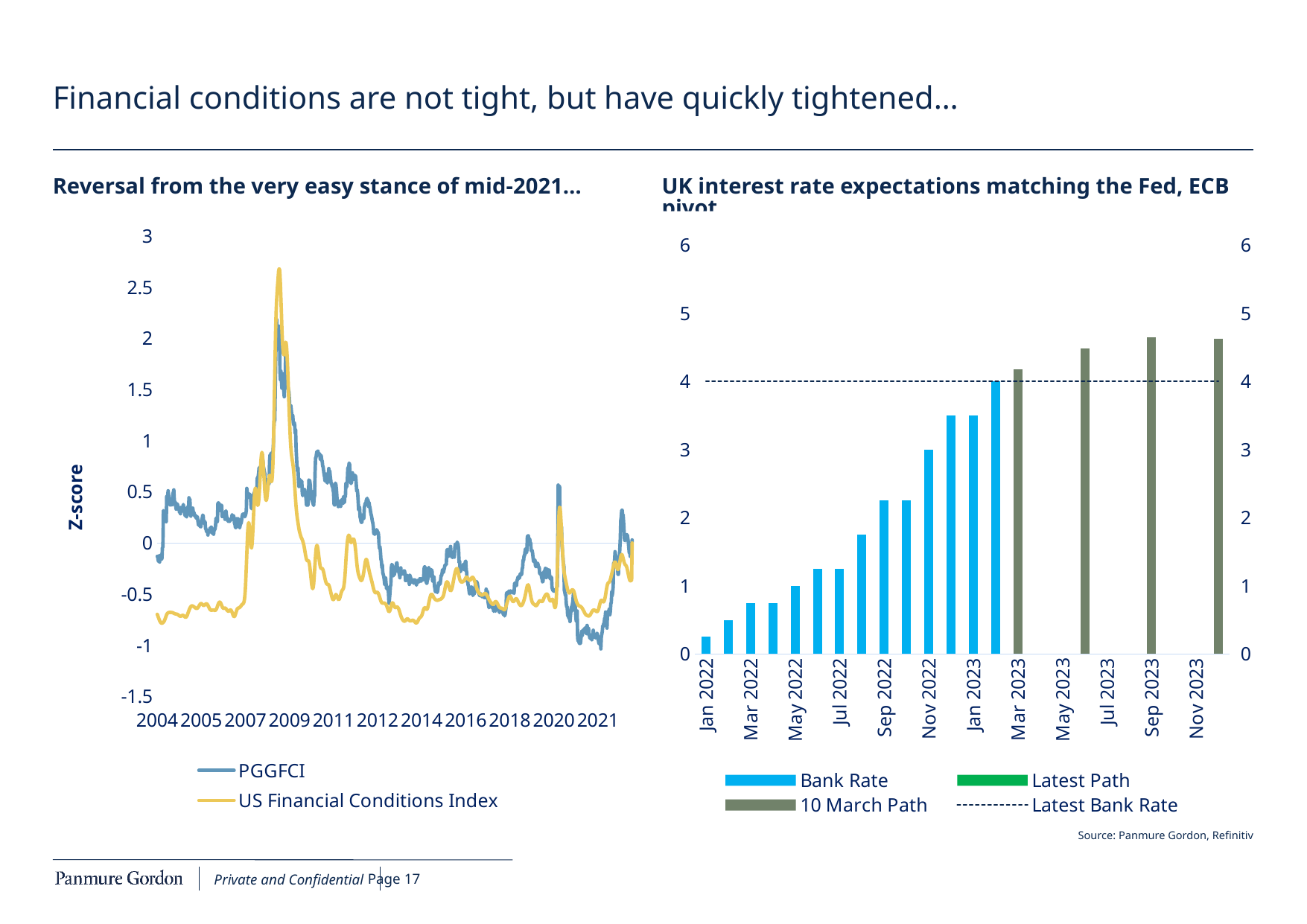
What kind of chart is the right chart titled "UK interest rate expectations matching the Fed, ECB pivot"? Bar chart In the right chart, does the Bank Rate rise or fall from Jan 2022 to Jan 2023? Rise What is the y-axis label of the left chart? Z-score How many series does the legend of the left chart list? 2 How many entries does the legend of the right chart list? 4 In the right chart, is the 10 March Path value for Sep 2023 greater or less than 4? greater In the left chart, is the US Financial Conditions Index value in 2004 greater or less than 0? less In the right chart, which is larger, the Bank Rate for Jan 2022 or the Bank Rate for Jan 2023? Jan 2023 In the right chart, is the Bank Rate value for Nov 2022 greater or less than 2? greater What kind of chart is the left chart titled "Reversal from the very easy stance of mid-2021..."? Line chart In the left chart, which series reaches the higher peak around 2008-2009, PGGFCI or US Financial Conditions Index? US Financial Conditions Index